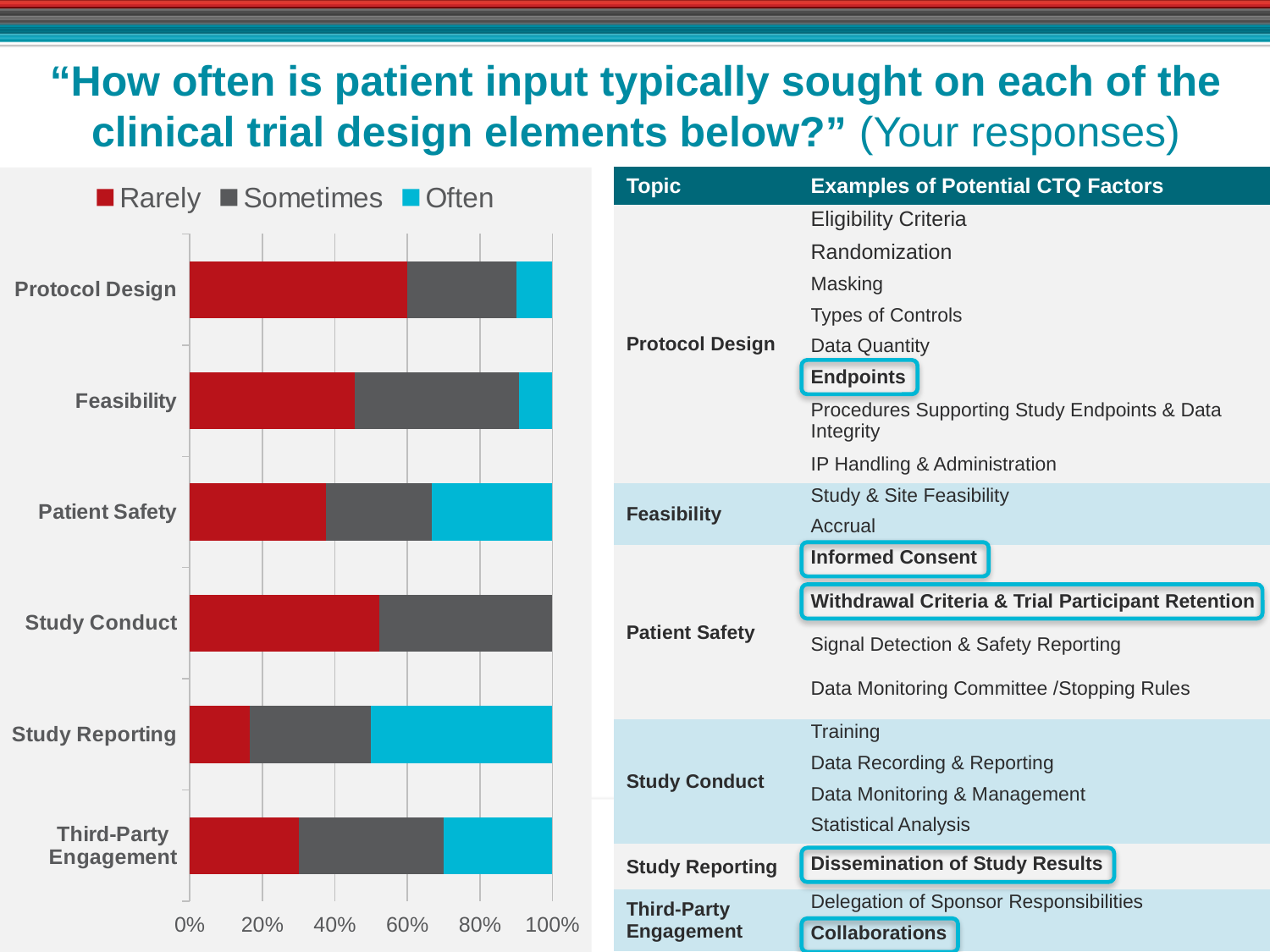
How many clinical trial design elements (categories) are plotted in the chart? 6 Which category has the largest 'Often' segment? Study Reporting Which category has the largest 'Rarely' segment? Protocol Design Is the 'Rarely' share for Study Reporting greater or less than 20%? less How many series does the chart legend list? 3 Is the 'Rarely' share for Protocol Design greater or less than 40%? greater Is the 'Often' share for Protocol Design greater or less than 20%? less Which colour represents the 'Often' series in the chart? Light blue Which category has the smallest 'Rarely' segment? Study Reporting What kind of chart is shown on the slide? Stacked bar chart What are the three response options listed in the chart legend? Rarely, Sometimes, Often